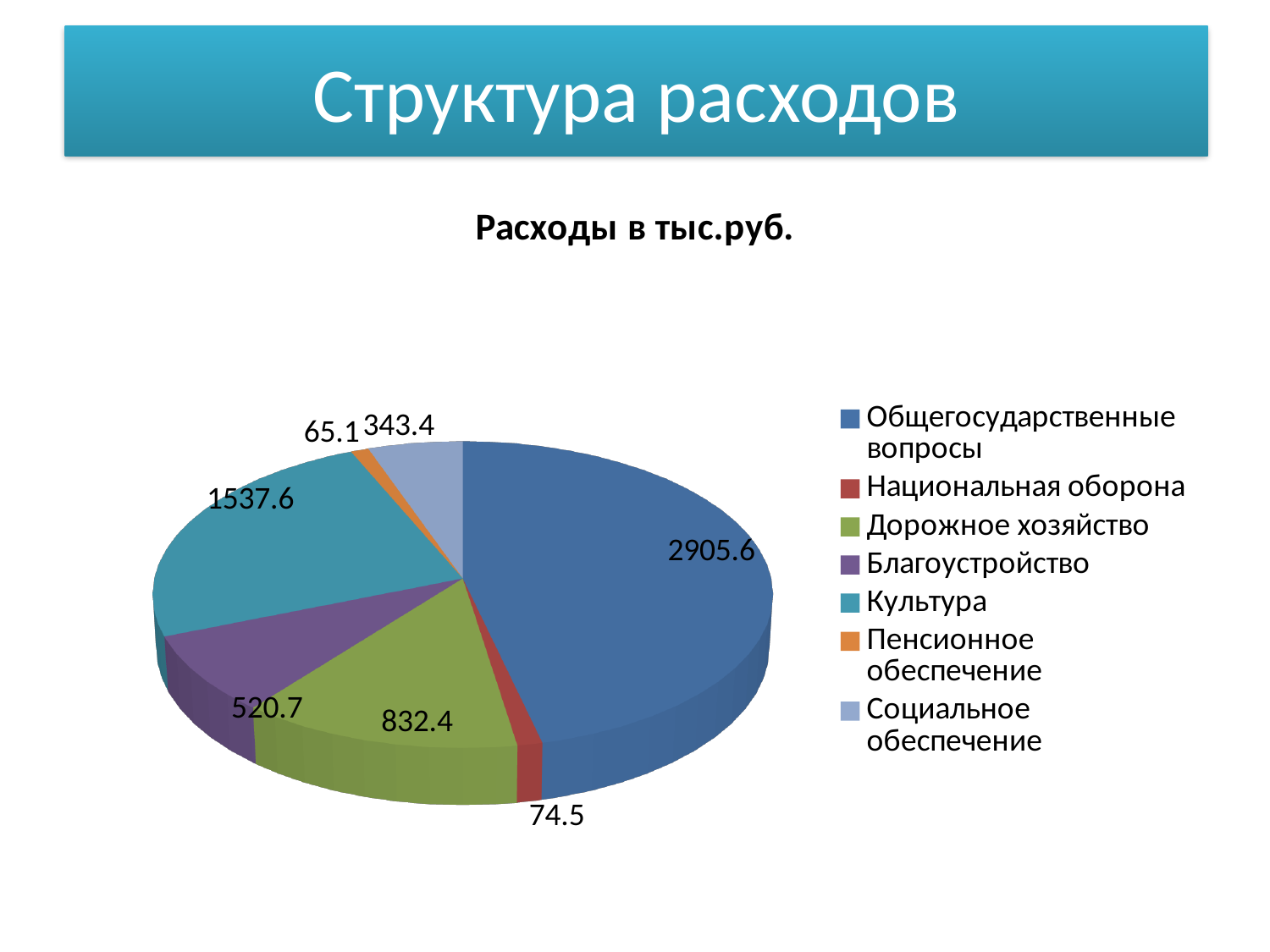
What is the value for Культура? 1537.6 What is the value for Дорожное хозяйство? 832.4 Which category has the largest value? Общегосударственные вопросы What is the title of the chart? Расходы в тыс.руб. Which category has the smallest value? Пенсионное обеспечение How many categories does the legend list? 7 What is the value for Общегосударственные вопросы? 2905.6 What type of chart is shown on the slide? Pie chart What is the value for Пенсионное обеспечение? 65.1 Which is larger, the value for Благоустройство or the value for Социальное обеспечение? Благоустройство What colour is the slice for Культура? Teal What is the difference between the values for Культура and Дорожное хозяйство? 705.2